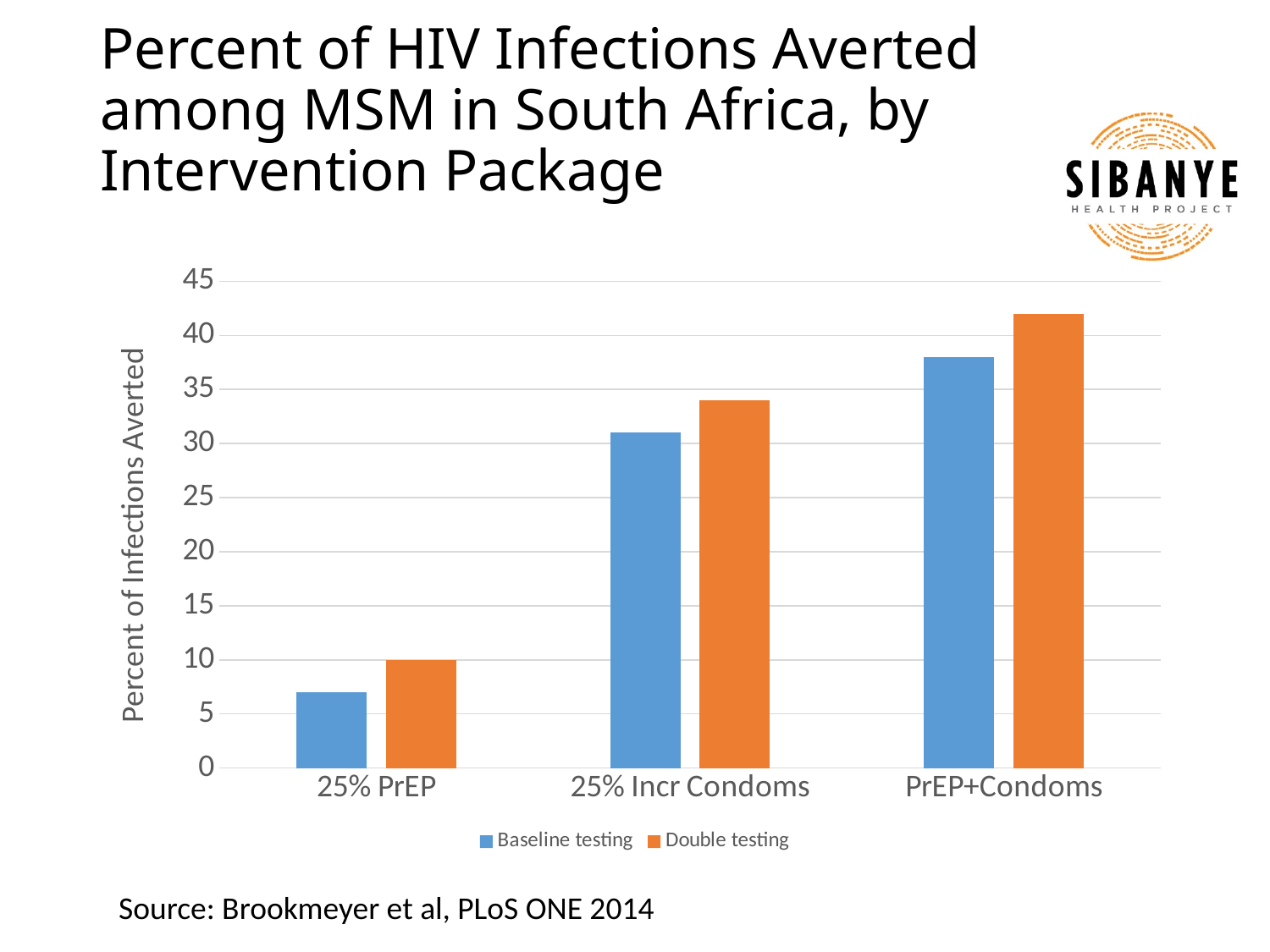
For 25% Incr Condoms, which is larger: Baseline testing or Double testing? Double testing How many series does the legend list? 2 Which intervention package has the lowest percent of infections averted under Baseline testing? 25% PrEP Is the Double testing value for 25% Incr Condoms greater or less than 30? greater Is the Baseline testing value for PrEP+Condoms greater or less than 35? greater Do the Baseline testing values rise or fall moving from left to right across the intervention packages? rise Which intervention package has the highest percent of infections averted under Double testing? PrEP+Condoms How many intervention package categories are shown on the x axis? 3 Is the Baseline testing value for 25% PrEP greater or less than 10? less What is the label of the y axis? Percent of Infections Averted What kind of chart is shown on the slide? bar chart